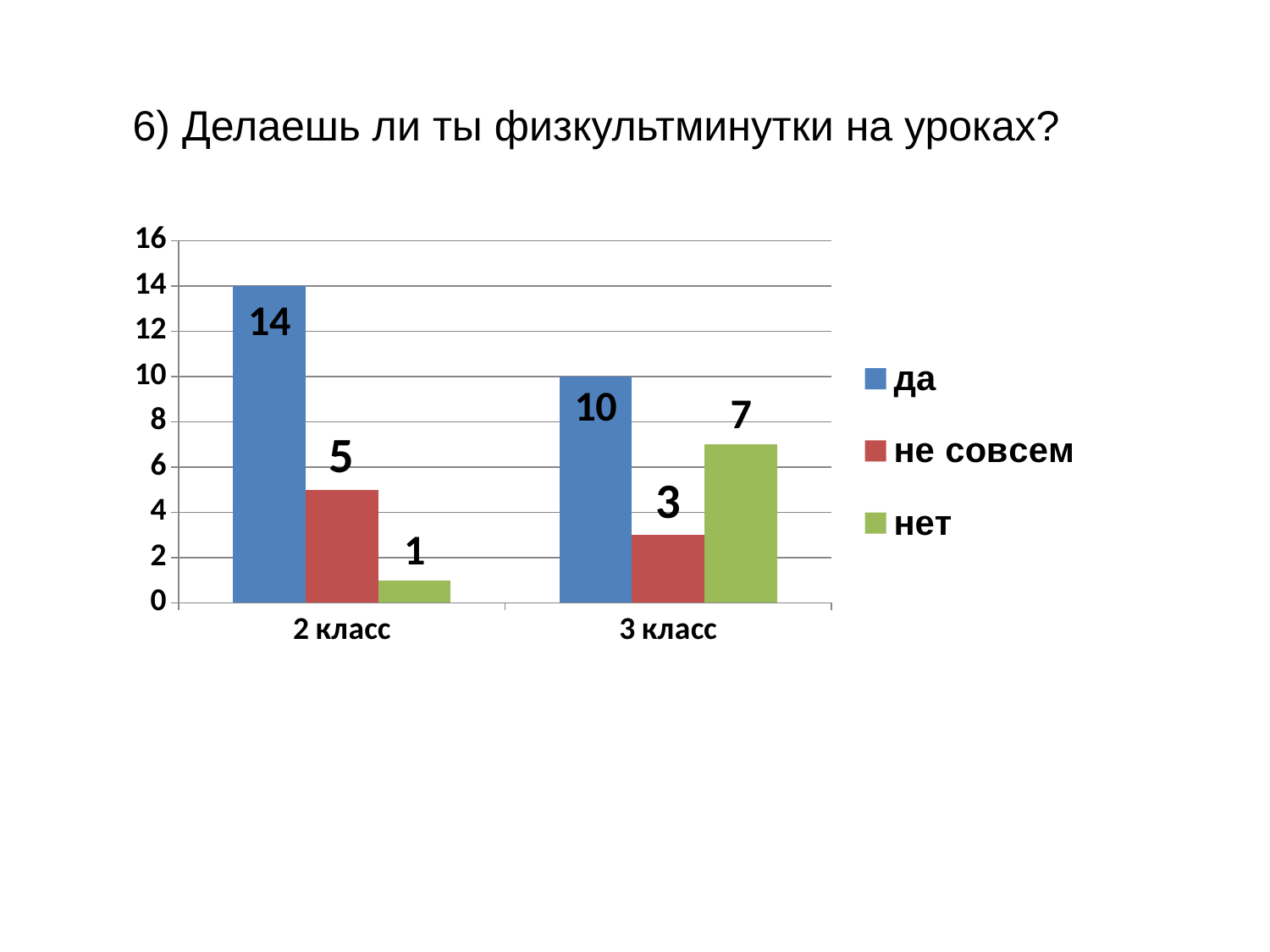
How many categories are shown on the x axis? 2 How many series does the legend list? 3 What is the value for "не совсем" in "3 класс"? 3 Which series has the lowest value in "3 класс"? не совсем Is the value for "да" in "3 класс" greater or less than 8? greater What is the value for "нет" in "3 класс"? 7 Which is larger: "нет" in "2 класс" or "нет" in "3 класс"? 3 класс Which series has the highest value in "2 класс"? да What is the value for "да" in "2 класс"? 14 What is the difference between the "да" values for "2 класс" and "3 класс"? 4 What colour represents the "не совсем" series? red What kind of chart is shown on the slide? bar chart